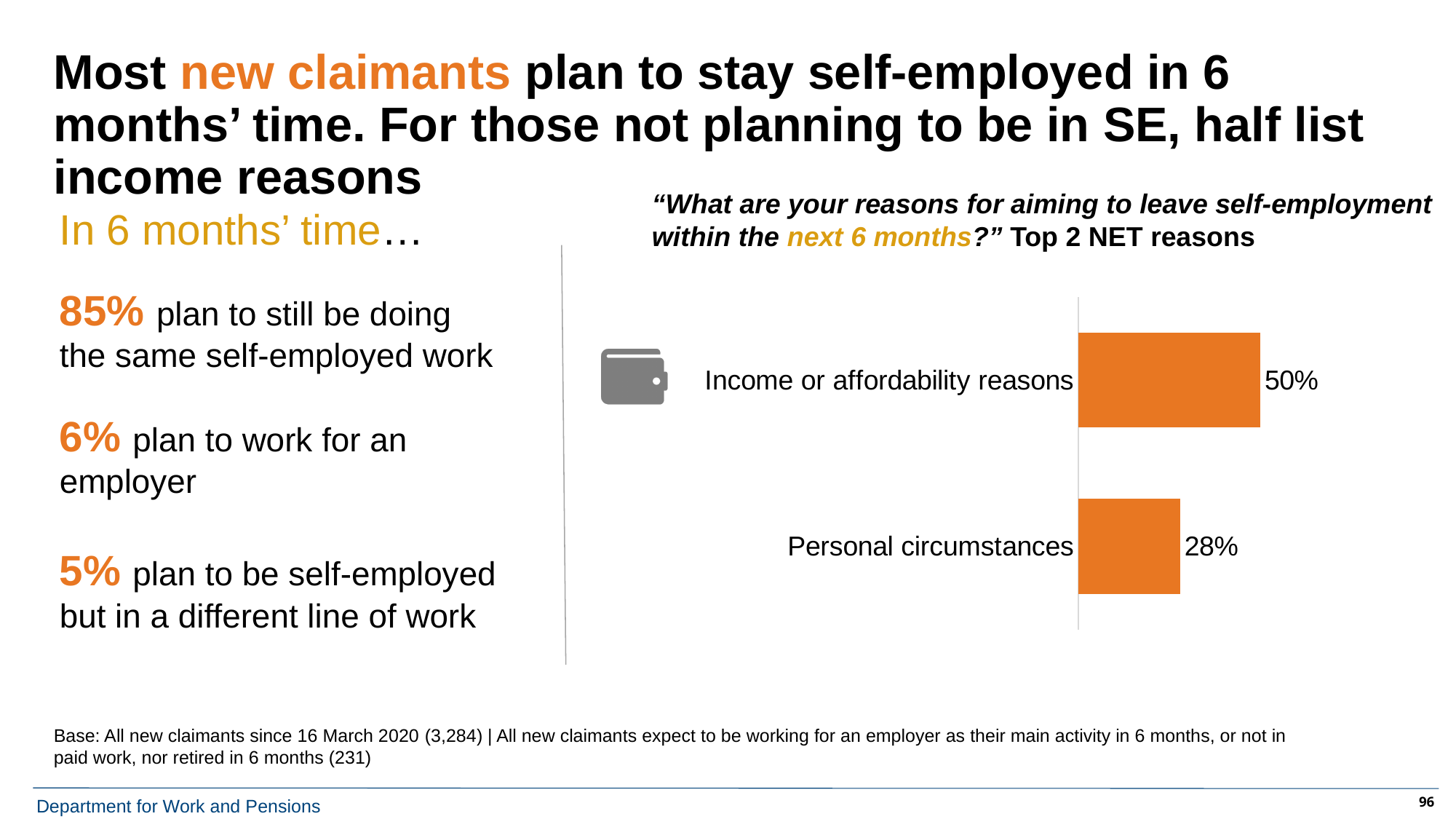
What is the value for Personal circumstances? 28% What is the difference between the values for Income or affordability reasons and Personal circumstances? 22 percentage points What is the value for Income or affordability reasons? 50% What kind of chart is shown on the slide? Bar chart What colour are the bars in the chart? Orange Which category has the highest value? Income or affordability reasons What question does the chart title say respondents were asked? "What are your reasons for aiming to leave self-employment within the next 6 months?" Which is larger: the value for Income or affordability reasons or the value for Personal circumstances? Income or affordability reasons Which category has the lowest value? Personal circumstances How many categories are shown in the chart? 2